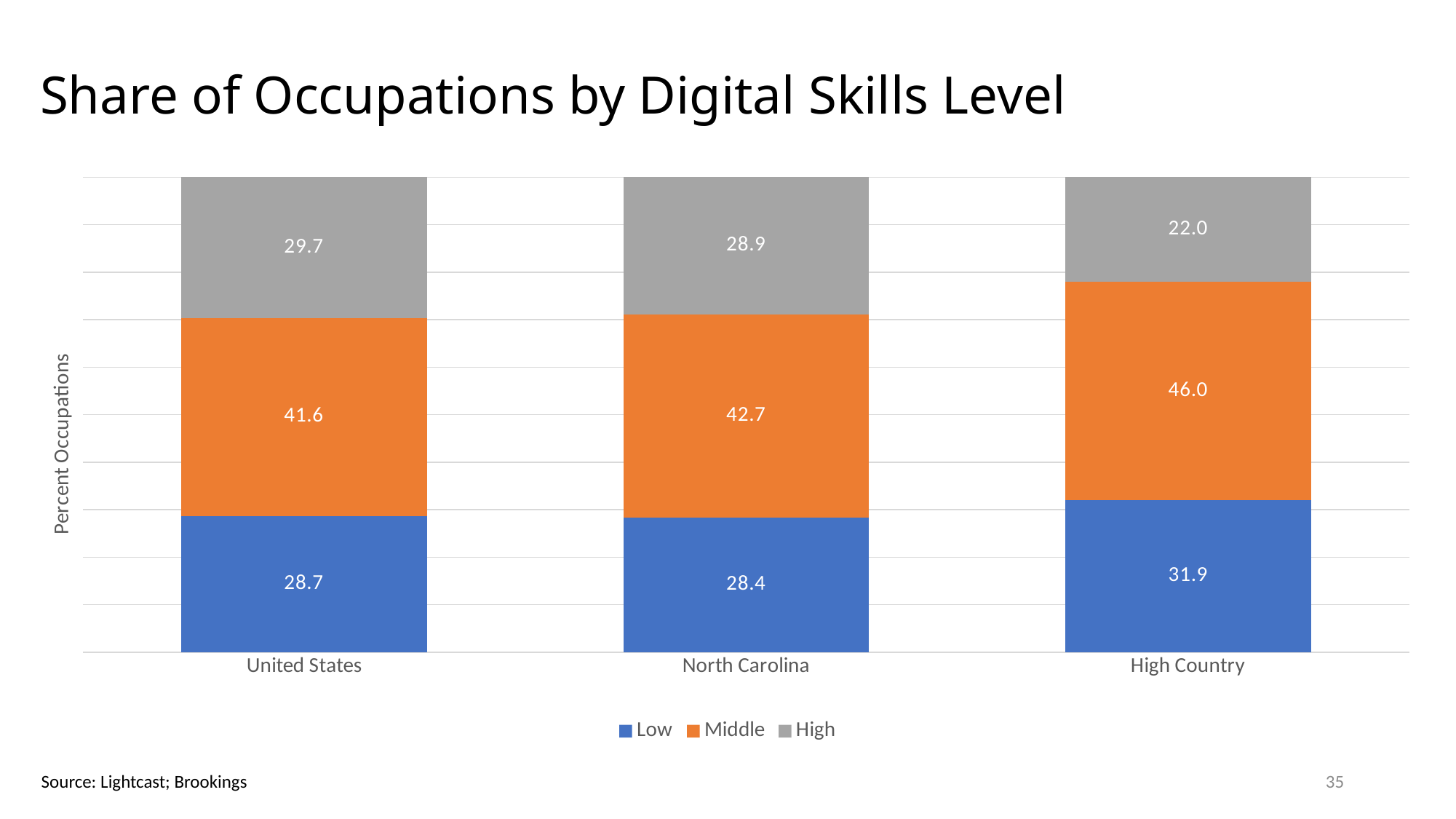
What is the total of the stacked bar for United States? 100.0 What is the High value for United States? 29.7 Which category has the highest Middle value? High Country What is the Middle value for High Country? 46.0 How many series does the legend list? 3 What kind of chart is shown on the slide? Stacked bar chart Which is larger, the Low value for High Country or the Low value for North Carolina? High Country What is the Low value for North Carolina? 28.4 How many categories are shown on the x axis? 3 Which category has the lowest High value? High Country What is the difference between the High value for United States and the High value for High Country? 7.7 What is the difference between the Middle value for High Country and the Middle value for United States? 4.4